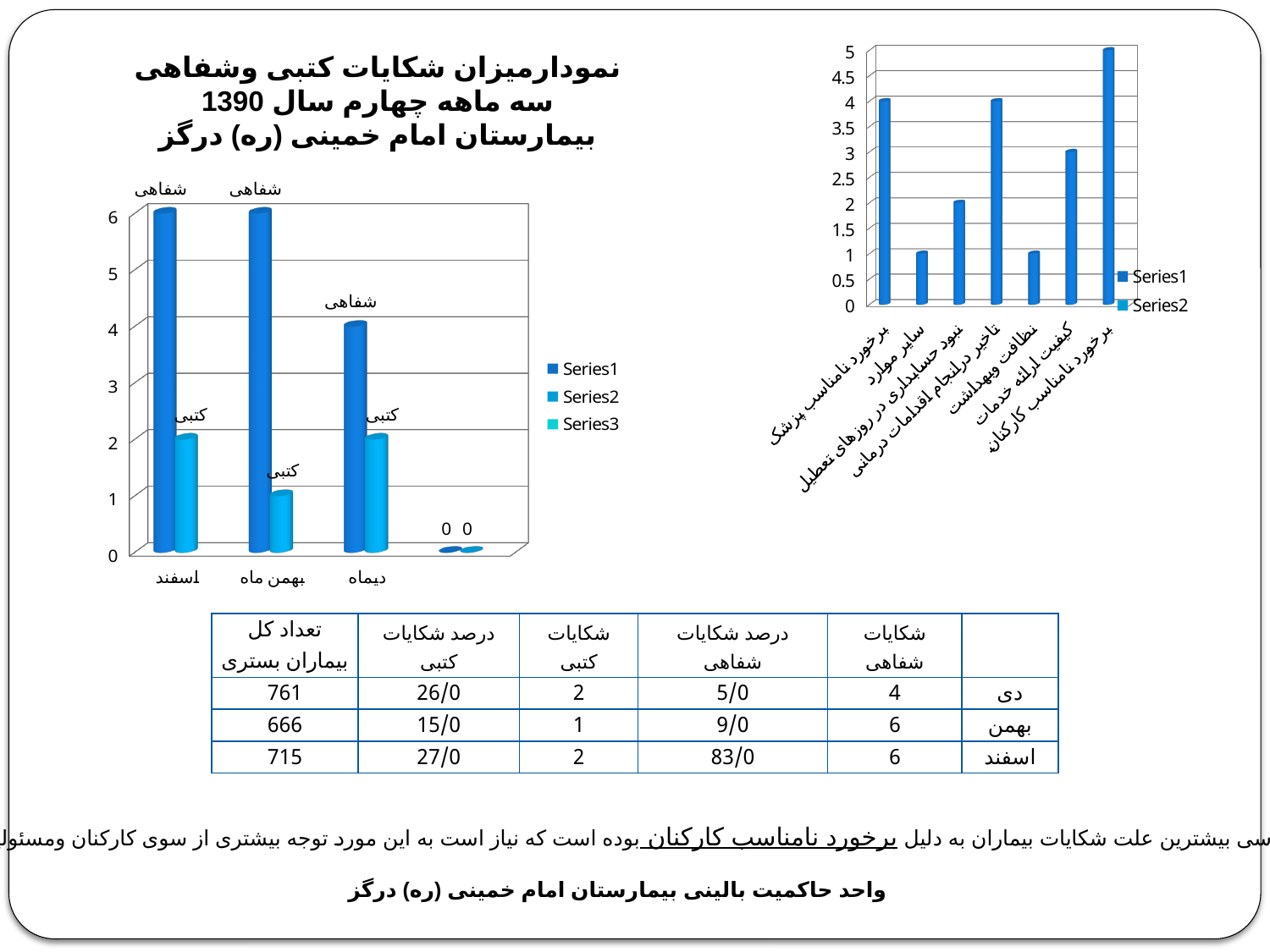
In the left chart (نمودارمیزان شکایات کتبی وشفاهی), what is the value of the شفاهی bar for اسفند? 6 In the left chart, what is the value of the کتبی bar for بهمن ماه? 1 In the left chart, how many series does the legend list? 3 In the left chart, what is the difference between the شفاهی and کتبی values for اسفند? 4 In the right chart, which is larger: the value for برخورد نامناسب پزشک or the value for سایر موارد? برخورد نامناسب پزشک In the left chart, which month has the lowest شفاهی value? دیماه In the right chart, what is the value for کیفیت ارائه خدمات? 3 In the right chart, how many categories are shown on the x axis? 7 In the left chart, what is the value of the شفاهی bar for دیماه? 4 What type of chart is the left chart? bar chart In the right chart, what is the value for نبود حسابداری در روزهای تعطیل? 2 In the right chart, which category has the highest value? برخورد نامناسب کارکنان